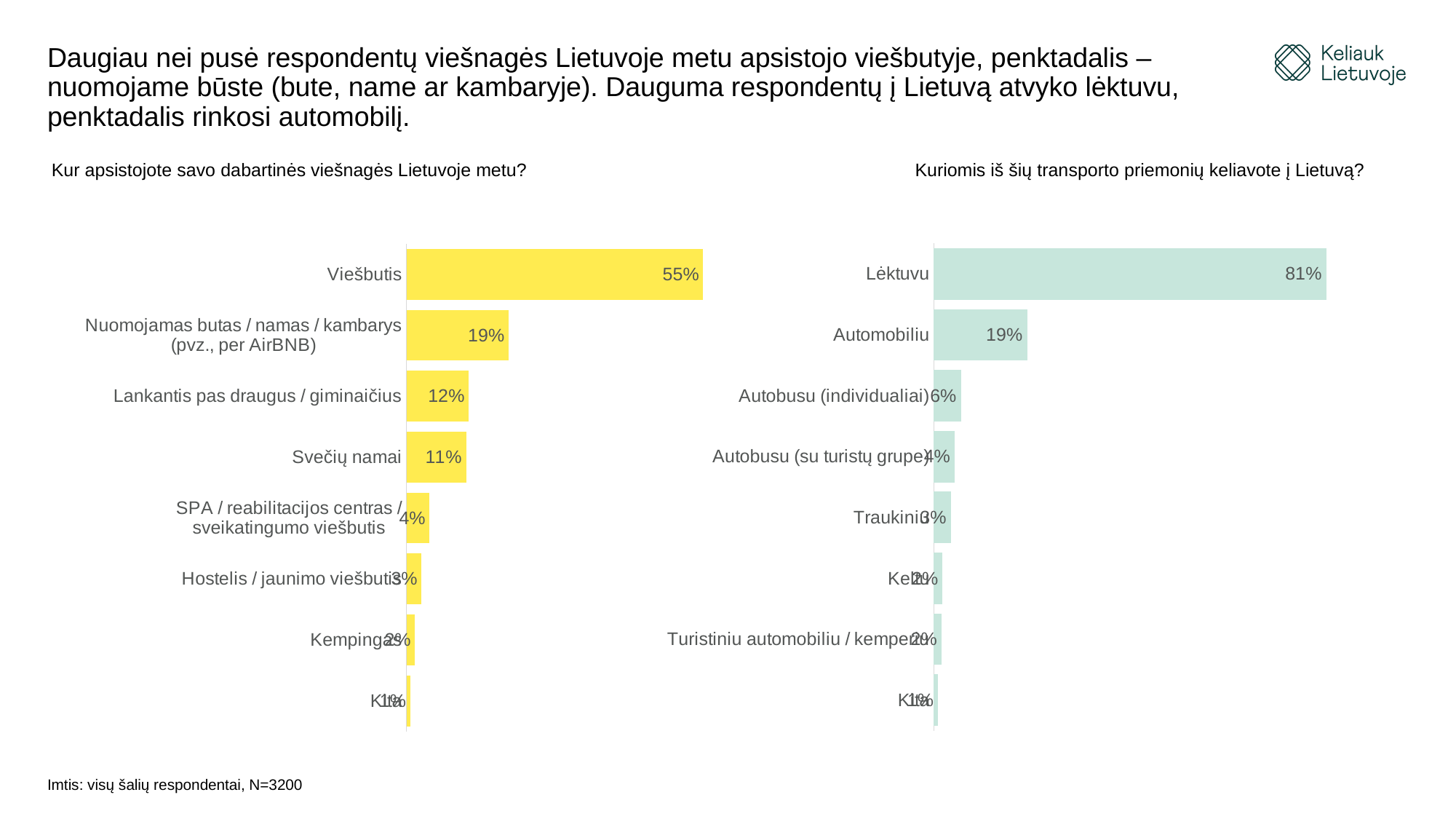
In the left chart (Kur apsistojote savo dabartinės viešnagės Lietuvoje metu?), what is the value for Lankantis pas draugus / giminaičius? 12% In the right chart (Kuriomis iš šių transporto priemonių keliavote į Lietuvą?), what is the value for Lėktuvu? 81% In the right chart (Kuriomis iš šių transporto priemonių keliavote į Lietuvą?), which is larger: Autobusu (su turistų grupe) or Traukiniu? Autobusu (su turistų grupe) In the left chart (Kur apsistojote savo dabartinės viešnagės Lietuvoje metu?), which category has the highest value? Viešbutis What type of chart is the right chart (Kuriomis iš šių transporto priemonių keliavote į Lietuvą?)? Bar chart In the left chart (Kur apsistojote savo dabartinės viešnagės Lietuvoje metu?), what is the value for Viešbutis? 55% In the left chart (Kur apsistojote savo dabartinės viešnagės Lietuvoje metu?), how many categories are shown? 8 In the left chart (Kur apsistojote savo dabartinės viešnagės Lietuvoje metu?), what is the difference between Viešbutis and Nuomojamas butas / namas / kambarys (pvz., per AirBNB)? 36% In the right chart (Kuriomis iš šių transporto priemonių keliavote į Lietuvą?), what is the value for Autobusu (individualiai)? 6% What colour are the bars in the left chart (Kur apsistojote savo dabartinės viešnagės Lietuvoje metu?)? Yellow In the right chart (Kuriomis iš šių transporto priemonių keliavote į Lietuvą?), what is the value for Automobiliu? 19% In the right chart (Kuriomis iš šių transporto priemonių keliavote į Lietuvą?), what is the difference between Lėktuvu and Automobiliu? 62%